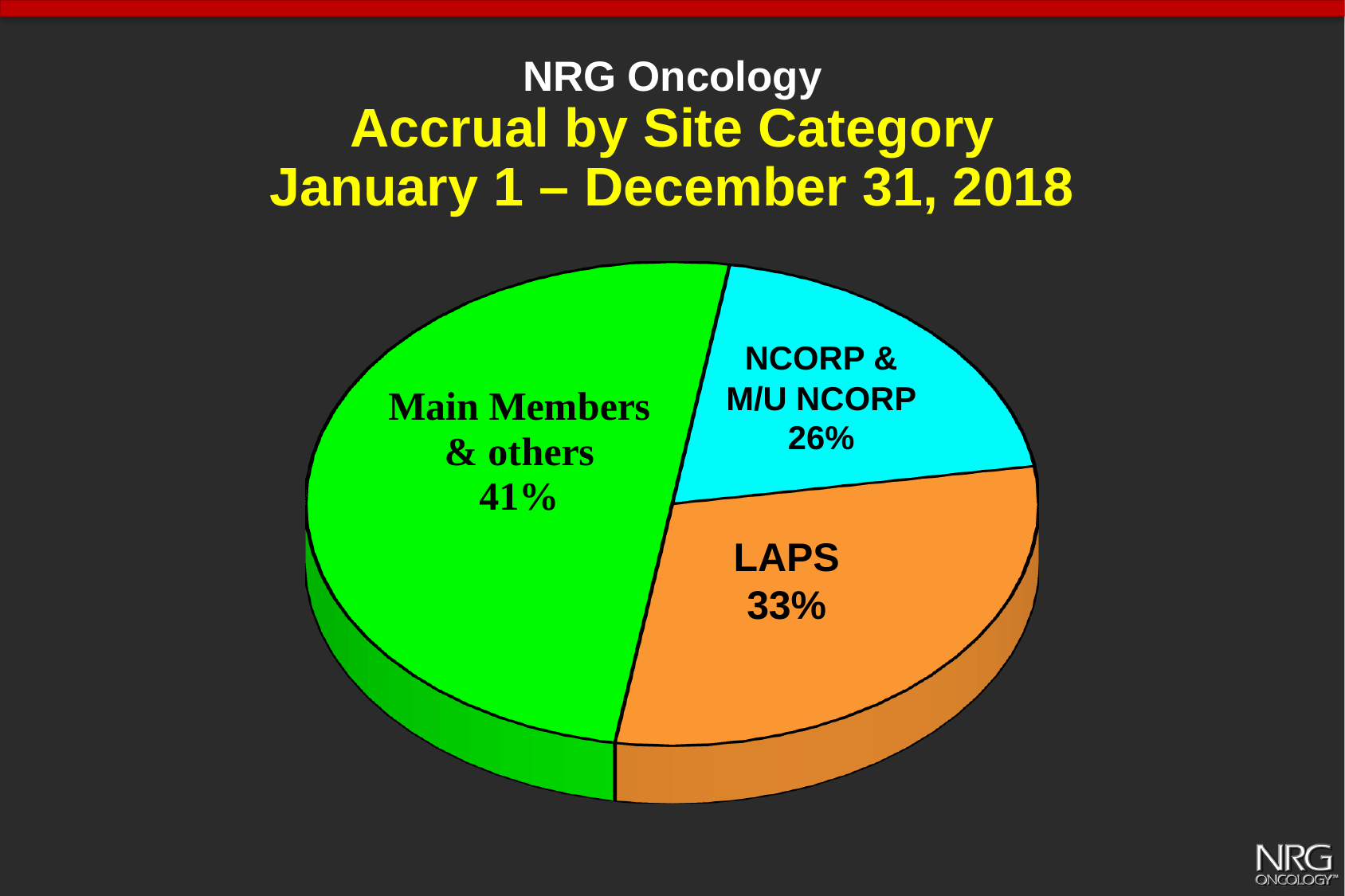
What share of accrual is attributed to NCORP & M/U NCORP? 26% What time period does the chart title say the accrual covers? January 1 – December 31, 2018 What is the difference in percentage points between the Main Members & others share and the LAPS share? 8 What is the difference in percentage points between the LAPS share and the NCORP & M/U NCORP share? 7 How many site categories are shown in the pie chart? 3 Which site category has the smallest share of accrual? NCORP & M/U NCORP What colour is the LAPS slice of the pie chart? Orange What share of accrual is attributed to Main Members & others? 41% Which has a larger share of accrual, LAPS or NCORP & M/U NCORP? LAPS Which site category has the largest share of accrual? Main Members & others What kind of chart is shown on the slide? Pie chart What share of accrual is attributed to LAPS? 33%